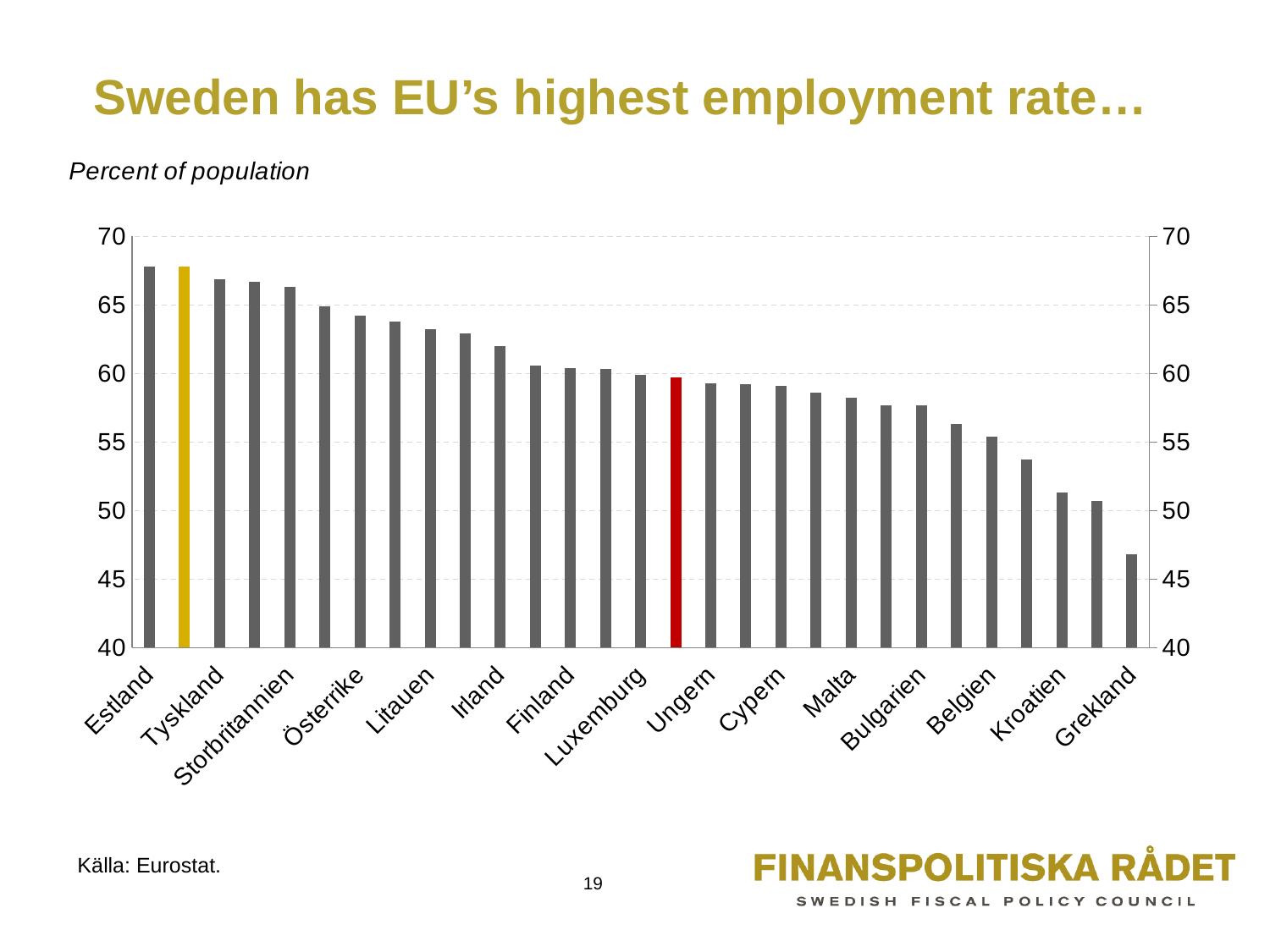
Is the value for Estland greater or less than 65? greater Which country has the lowest employment rate in the chart? Grekland What is the title of the slide? Sweden has EU's highest employment rate… Which is larger, the value for Tyskland or the value for Kroatien? Tyskland Is the value for Grekland greater or less than 50? less Is the value for Litauen greater or less than 65? less Which is larger, the value for Estland or the value for Grekland? Estland What is the source cited for the chart? Eurostat What kind of chart is shown on the slide? bar chart Do the values rise or fall moving from left to right along the x axis? fall